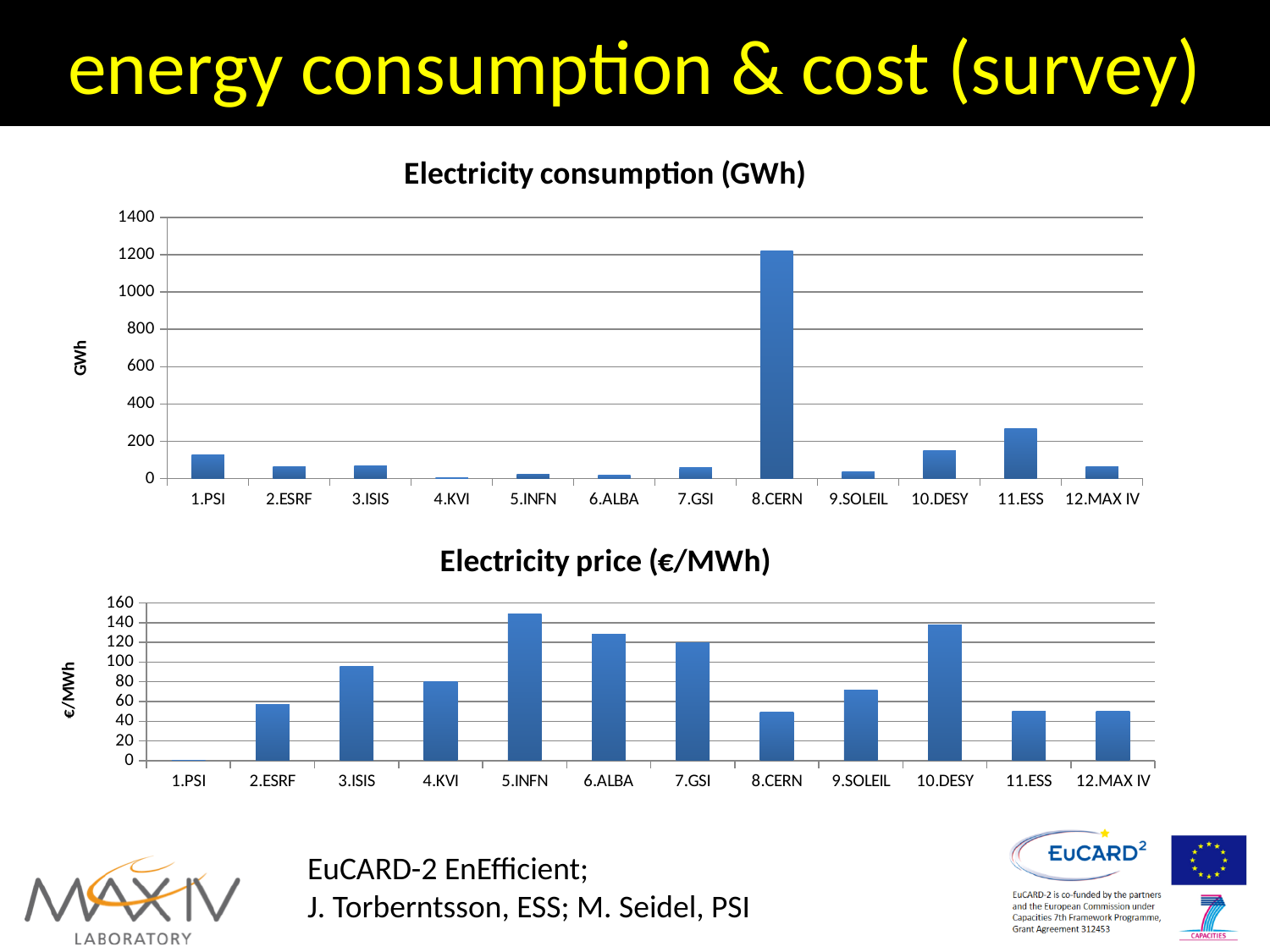
In the Electricity price (€/MWh) chart, is the value for 8.CERN greater or less than 60? less In the Electricity price (€/MWh) chart, is the value for 3.ISIS greater or less than 80? greater What is the y-axis label of the Electricity consumption chart? GWh In the Electricity consumption (GWh) chart, which facility has the highest electricity consumption? 8.CERN In the Electricity consumption (GWh) chart, is the value for 8.CERN greater or less than 1000? greater In the Electricity price (€/MWh) chart, which has the higher electricity price, 9.SOLEIL or 10.DESY? 10.DESY What kind of chart is the Electricity price (€/MWh) chart? bar chart In the Electricity consumption (GWh) chart, which facility has the lowest electricity consumption? 4.KVI In the Electricity price (€/MWh) chart, which facility has the lowest electricity price? 1.PSI How many facilities are shown on the x axis of the Electricity consumption (GWh) chart? 12